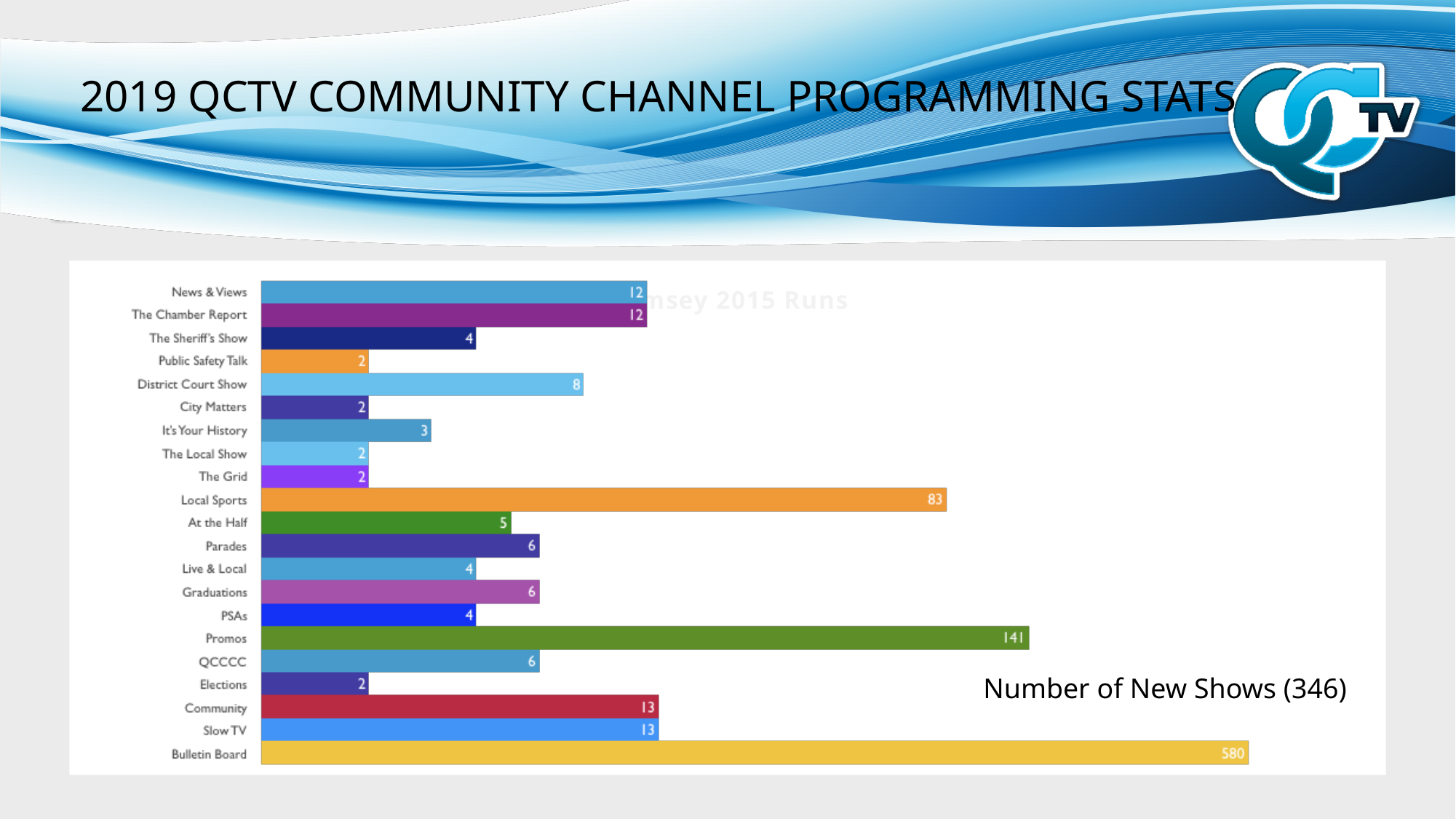
Which category has the highest value? Bulletin Board What is the difference between the values for Promos and Local Sports? 58 What is the value for Local Sports? 83 What is the value for District Court Show? 8 Which has a larger value, It's Your History or At the Half? At the Half What is the value for Bulletin Board? 580 What kind of chart is shown on the slide? Bar chart Which has a larger value, Community or The Sheriff's Show? Community What is the difference between the values for Bulletin Board and Promos? 439 What is the value for Promos? 141 What total number of new shows is stated in the text next to the chart? 346 How many categories are shown in the chart? 21